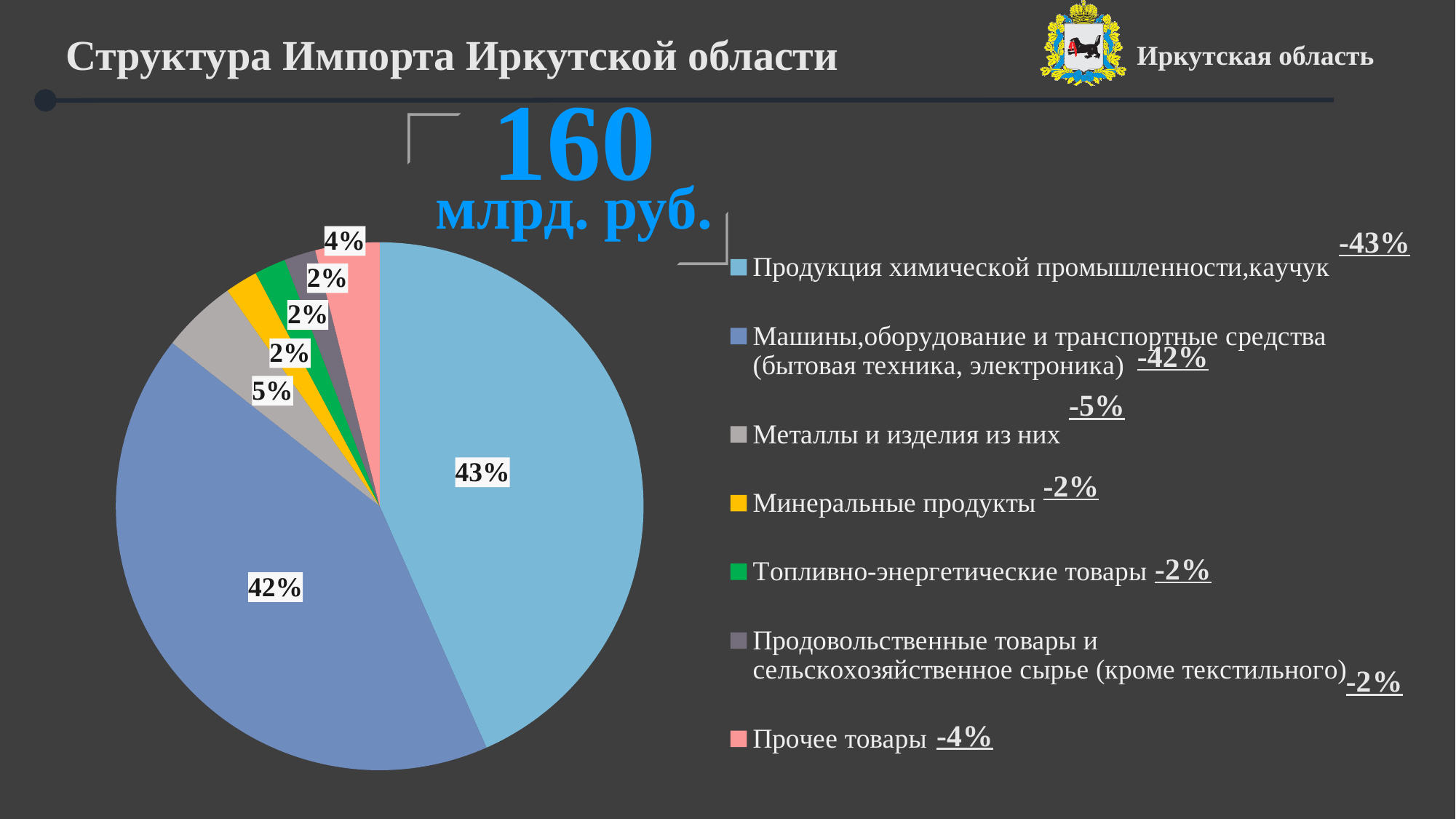
What share of imports does Минеральные продукты account for? 2% What share of imports does Прочее товары account for? 4% What total import value is shown above the chart? 160 млрд. руб. What share of imports does Продукция химической промышленности, каучук account for? 43% What kind of chart is shown on the slide? pie chart What share of imports does Машины, оборудование и транспортные средства (бытовая техника, электроника) account for? 42% How many slices does the pie chart have? 7 Which category has the largest share of the pie? Продукция химической промышленности, каучук What is the title of the slide containing the chart? Структура Импорта Иркутской области What is the difference in percentage points between the share for Продукция химической промышленности, каучук and the share for Металлы и изделия из них? 38 percentage points Which is larger: the share for Металлы и изделия из них or the share for Прочее товары? Металлы и изделия из них What share of imports does Металлы и изделия из них account for? 5%